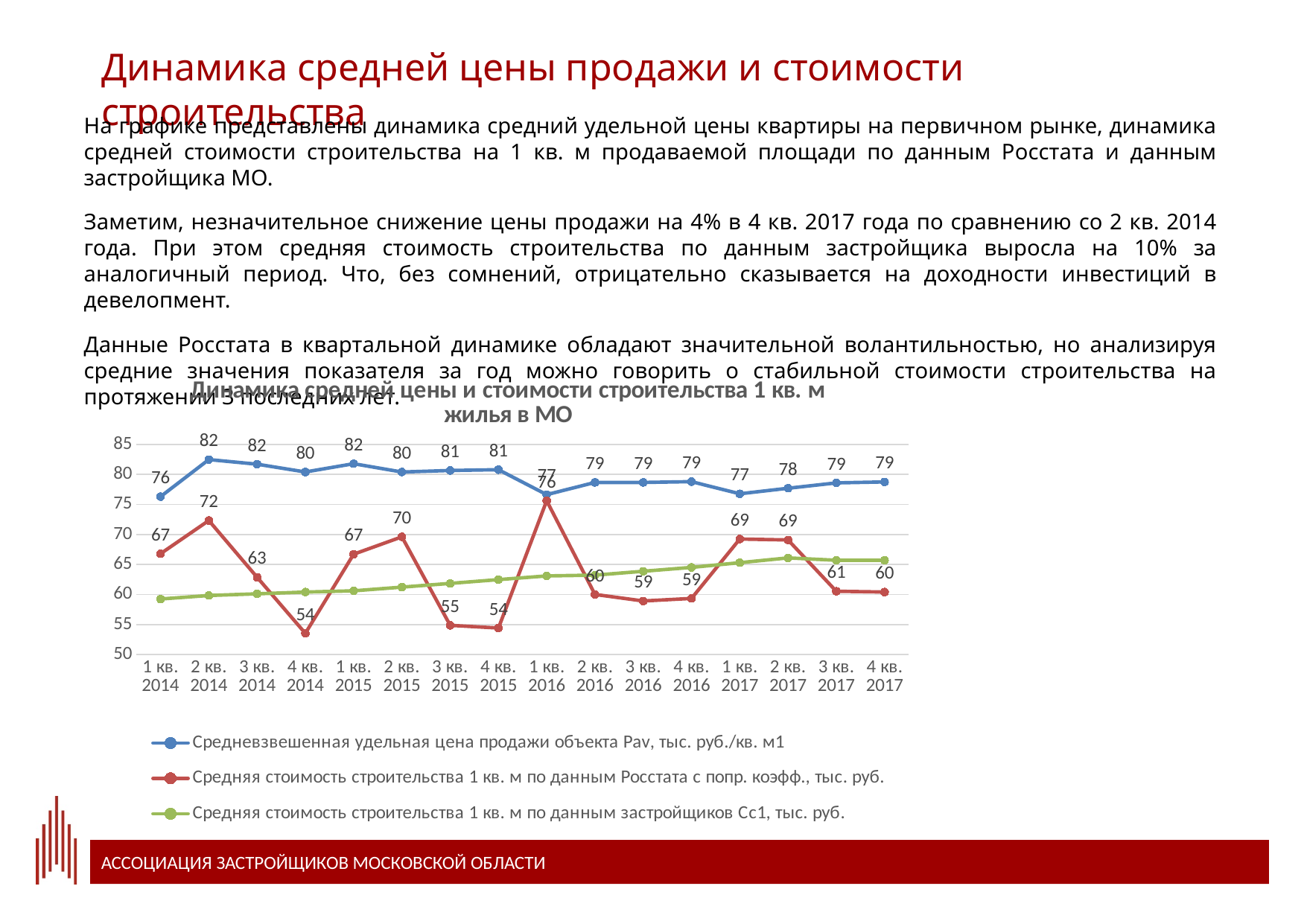
Which is larger in 2 кв. 2015: the blue series (цена продажи) or the red series (по данным Росстата)? blue series (цена продажи) What is the value of the blue series (Средневзвешенная удельная цена продажи) for 2 кв. 2014? 82 Does the green series (по данным застройщиков Сс1) rise or fall from 1 кв. 2014 to 4 кв. 2017? rise What type of chart is shown on the slide? line chart What is the value of the blue series (цена продажи) for 4 кв. 2017? 79 What is the value of the red series (стоимость строительства по данным Росстата) for 1 кв. 2016? 76 How many quarters are plotted along the x axis? 16 What is the difference between the blue series value and the red series value in 4 кв. 2017? 19 How many series does the legend list? 3 Is the value of the green series (по данным застройщиков Сс1) for 1 кв. 2014 greater or less than 65? less In which quarter does the red series (по данным Росстата) reach its highest value? 1 кв. 2016 What is the value of the red series (по данным Росстата) for 4 кв. 2014? 54